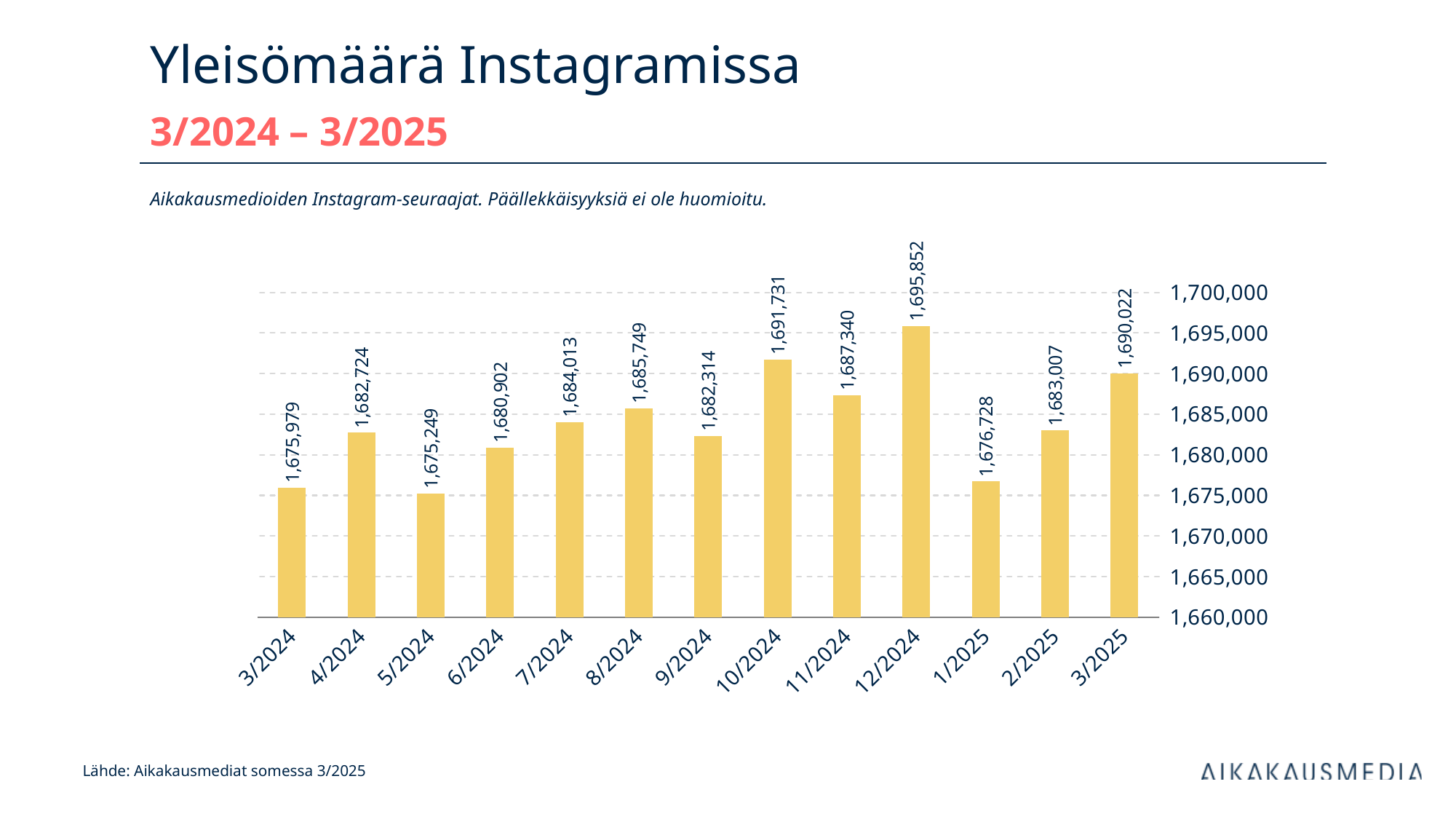
What is the difference between the values for 12/2024 and 3/2024? 19,873 How many months are shown on the x axis? 13 Which is larger, the value for 11/2024 or the value for 2/2025? 11/2024 Which month has the highest value? 12/2024 What kind of chart is shown on the slide? bar chart What is the value for 1/2025? 1,676,728 What is the difference between the values for 3/2025 and 3/2024? 14,043 What is the value for 12/2024? 1,695,852 Which month has the lowest value? 5/2024 What is the value for 3/2024? 1,675,979 Is the value for 10/2024 greater or less than 1,690,000? greater What is the title of the slide? Yleisömäärä Instagramissa